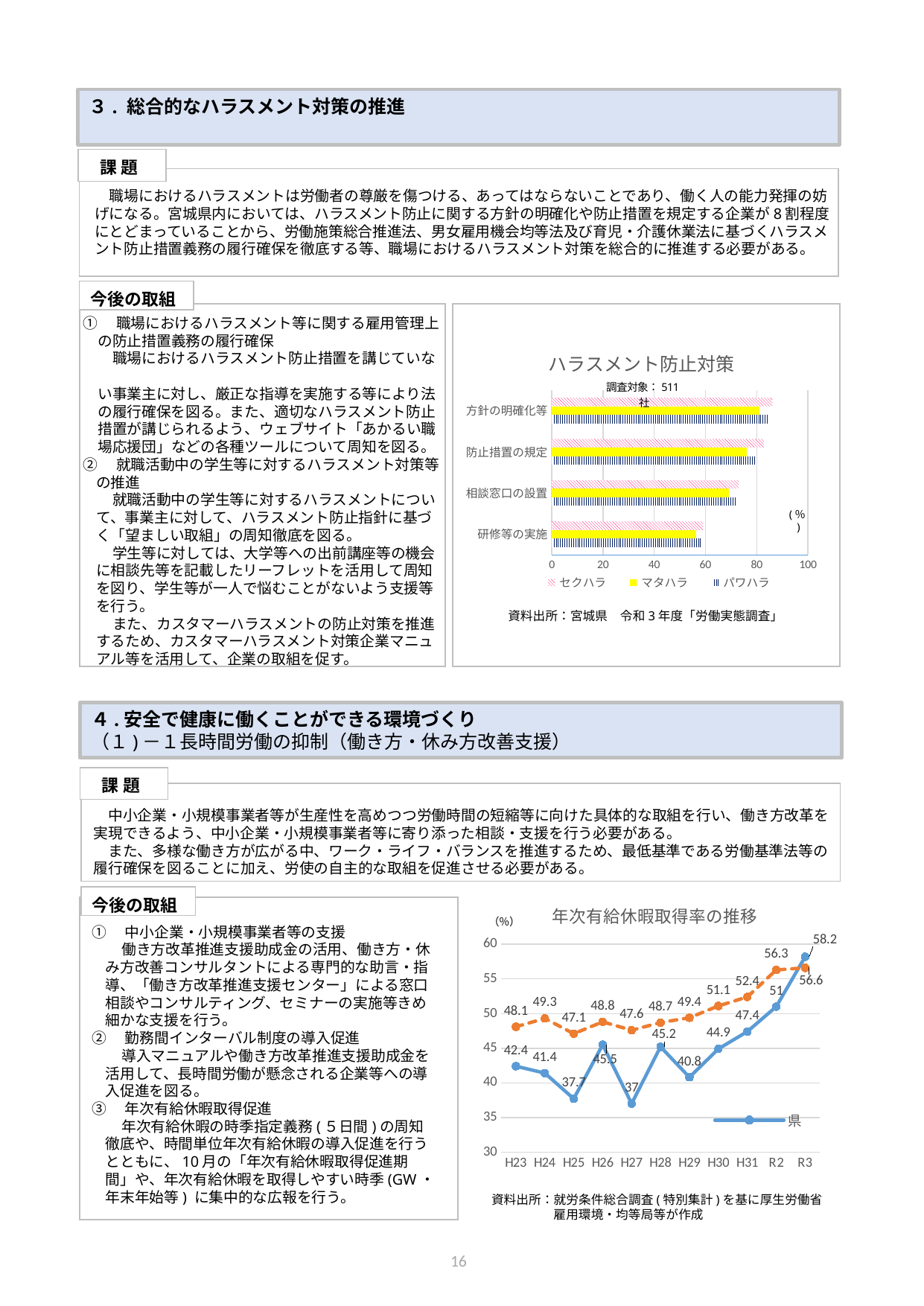
In the 年次有給休暇取得率の推移 chart, what is the 県 value for H27? 37 How many years are plotted on the x axis of the 年次有給休暇取得率の推移 chart? 11 How many categories are shown in the ハラスメント防止対策 chart? 4 In the ハラスメント防止対策 chart, which category has the lowest values across all three series? 研修等の実施 What kind of chart is the ハラスメント防止対策 chart? bar chart In the 年次有給休暇取得率の推移 chart, which is larger for 県: H26 or H29? H26 In the 年次有給休暇取得率の推移 chart, what is the difference between the 県 values for R3 and R2? 7.2 In the 年次有給休暇取得率の推移 chart, what is the 県 value for R3? 58.2 How many series does the legend of the ハラスメント防止対策 chart list? 3 In the 年次有給休暇取得率の推移 chart, in which year is the 県 value lowest? H27 In the ハラスメント防止対策 chart, is the セクハラ value for 方針の明確化等 greater or less than 80? greater